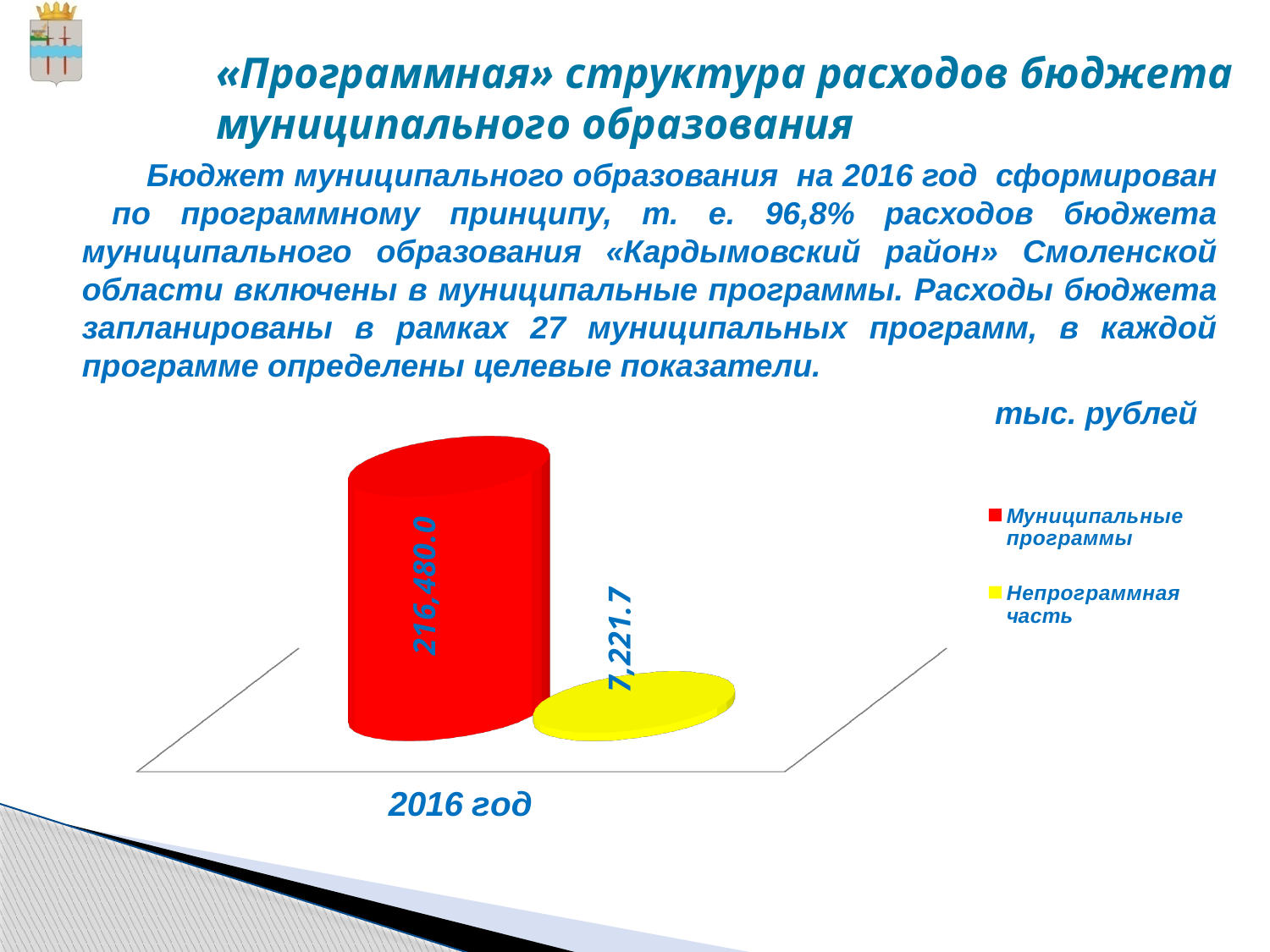
What kind of chart is shown on the slide? bar chart Which series has the higher value in 2016 год? Муниципальные программы Which series has the lower value in 2016 год? Непрограммная часть How many categories are shown on the x axis of the chart? 1 What unit is indicated above the chart? тыс. рублей What is the difference between the values for Муниципальные программы and Непрограммная часть in 2016 год? 209,258.3 How many series does the legend list? 2 What is the value for Непрограммная часть in 2016 год? 7,221.7 Is the value for Муниципальные программы larger or smaller than the value for Непрограммная часть? larger What is the category label shown on the x axis of the chart? 2016 год What is the value for Муниципальные программы in 2016 год? 216,480.0